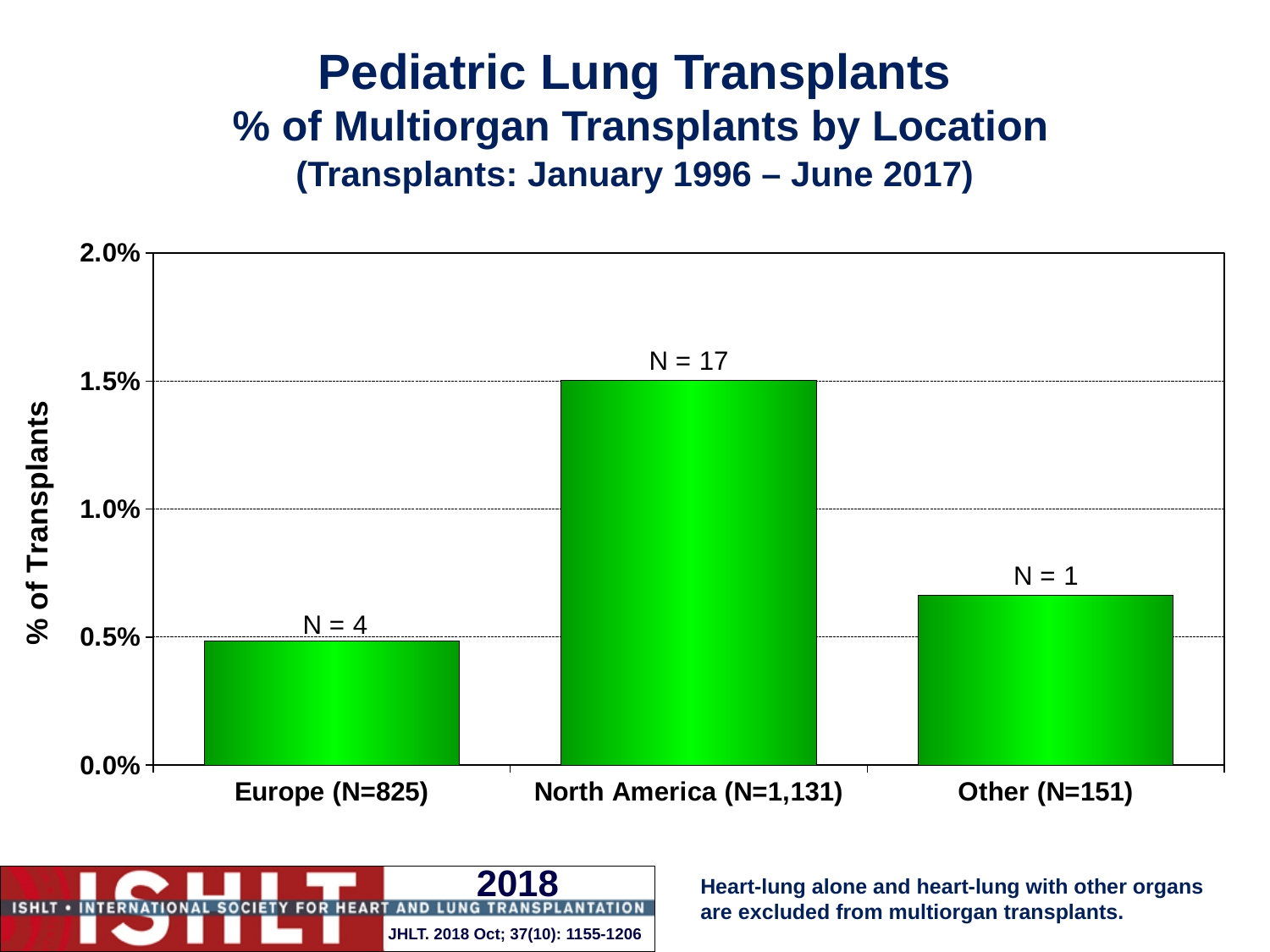
What is the label of the y axis? % of Transplants What is the N value labelled above the bar for North America (N=1,131)? N = 17 Which location has the lowest % of transplants? Europe (N=825) How many location categories are shown on the x axis? 3 Is the value for North America (N=1,131) greater or less than 1.0%? greater Which has a higher % of transplants, Europe (N=825) or Other (N=151)? Other (N=151) What kind of chart is shown on the slide? bar chart What is the N value labelled above the bar for Other (N=151)? N = 1 What is the N value labelled above the bar for Europe (N=825)? N = 4 Which location has the highest % of transplants? North America (N=1,131) Is the value for Other (N=151) greater or less than 0.5%? greater